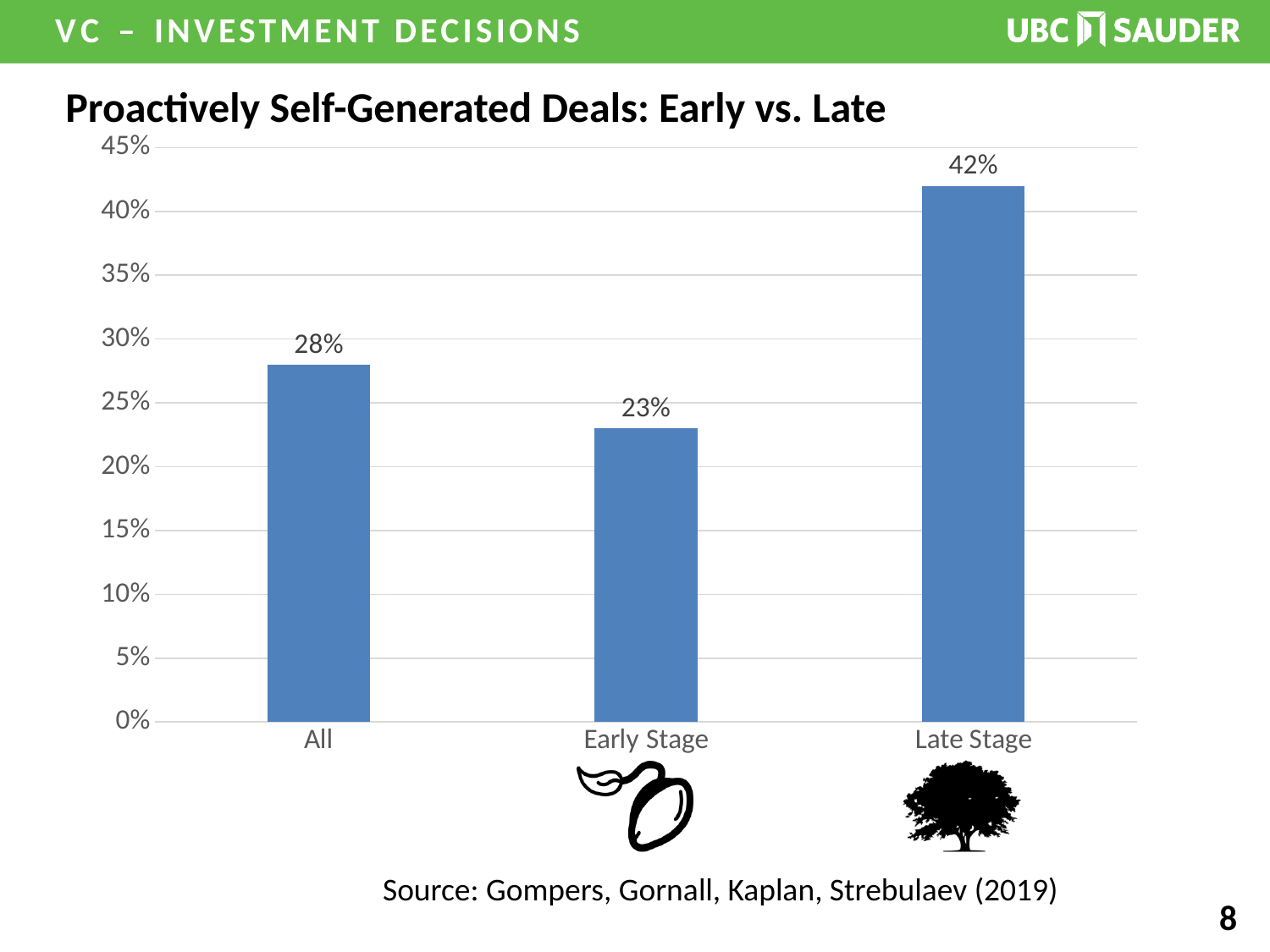
Which is larger, the value for All or the value for Early Stage? All What is the difference between the All and Early Stage values? 5% Is the value for Late Stage greater or less than 40%? greater What is the difference between the Late Stage and Early Stage values? 19% What is the value for Late Stage? 42% What is the value for Early Stage? 23% What is the value for All? 28% Which category has the lowest value? Early Stage What is the title of the chart? Proactively Self-Generated Deals: Early vs. Late What kind of chart is shown on the slide? bar chart How many categories are shown on the x axis? 3 Which category has the highest value? Late Stage